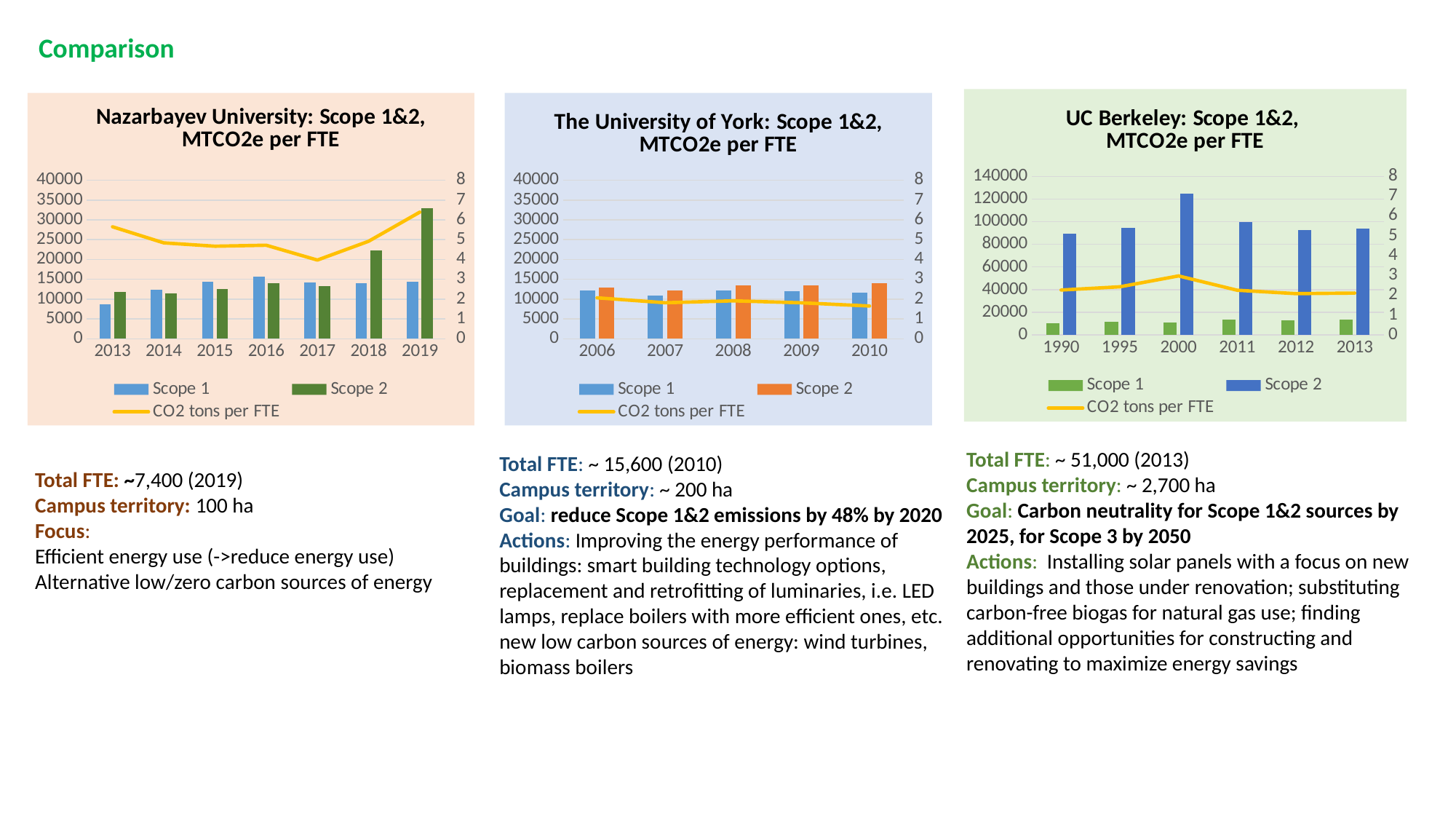
In The University of York chart, does the CO2 tons per FTE line rise or fall from 2006 to 2010? fall What kind of chart is the Nazarbayev University chart? bar chart with a line In the UC Berkeley chart, is the Scope 1 value for 1990 greater or less than 20000? less In the Nazarbayev University chart, how many series does the legend list? 3 In the UC Berkeley chart, which year has the highest Scope 2 value? 2000 In the Nazarbayev University chart, how many years are shown on the x axis? 7 In the Nazarbayev University chart, which year has the highest Scope 2 value? 2019 In the Nazarbayev University chart, which year has the lowest Scope 1 value? 2013 In the Nazarbayev University chart, is the Scope 2 value for 2019 greater or less than 30000? greater In The University of York chart, how many years are shown on the x axis? 5 In The University of York chart, is the Scope 2 value for 2010 greater or less than 10000? greater In the UC Berkeley chart, which is larger in 2013, Scope 1 or Scope 2? Scope 2